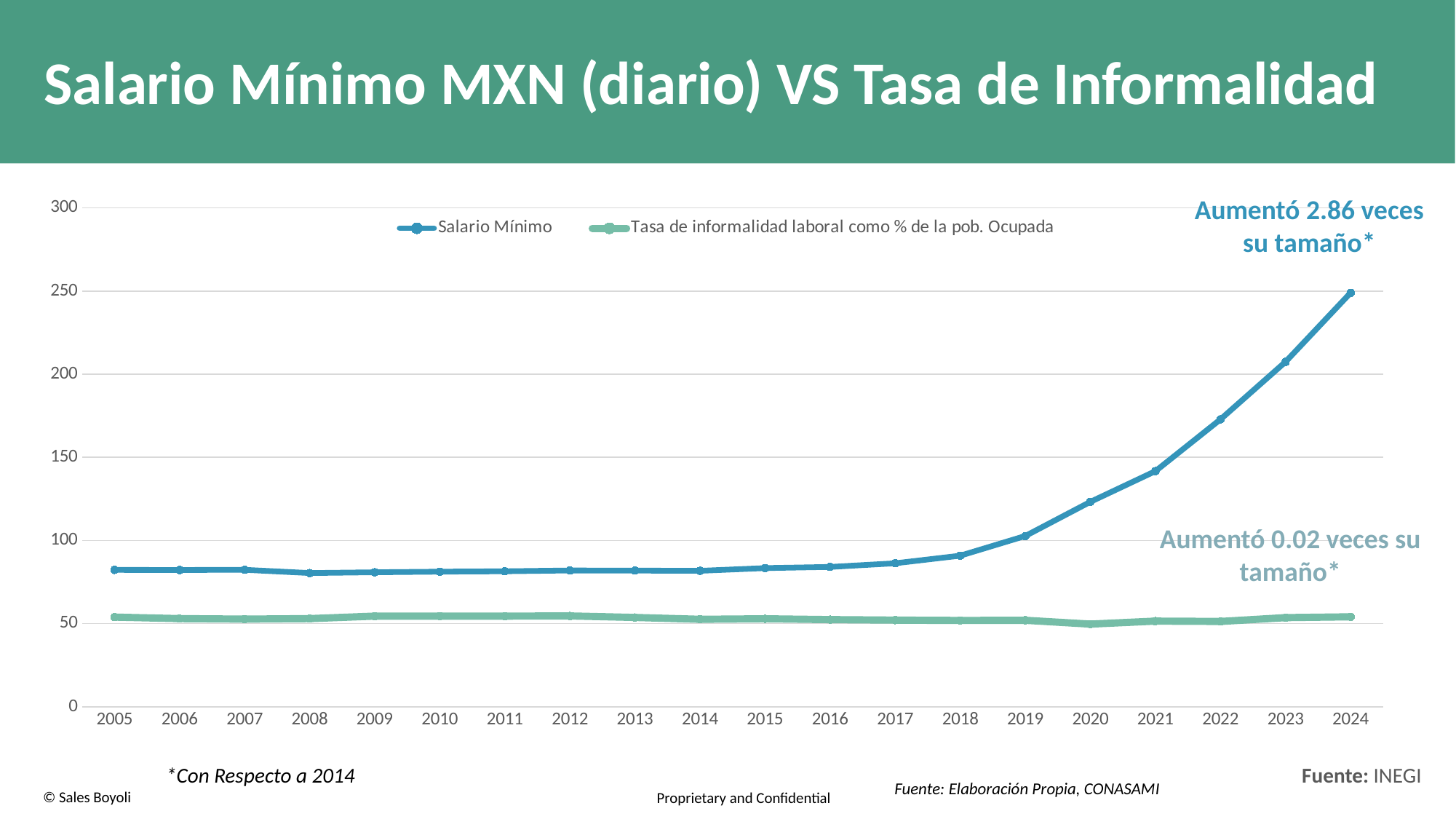
Is the value for Salario Mínimo in 2022 greater or less than 150? greater In which year is the Tasa de informalidad laboral series at its lowest? 2020 What kind of chart is shown on the slide? line chart Which series has the larger value in 2024, Salario Mínimo or Tasa de informalidad laboral? Salario Mínimo Does the Salario Mínimo series rise or fall between 2018 and 2024? rise How many series does the legend list? 2 Is the value for Salario Mínimo in 2024 greater or less than 200? greater Is the value for Tasa de informalidad laboral in 2015 greater or less than 100? less In which year is the Salario Mínimo series at its highest? 2024 How many years are plotted along the x axis? 20 According to the annotation on the chart, by how many times did the Salario Mínimo increase its size with respect to 2014? 2.86 veces